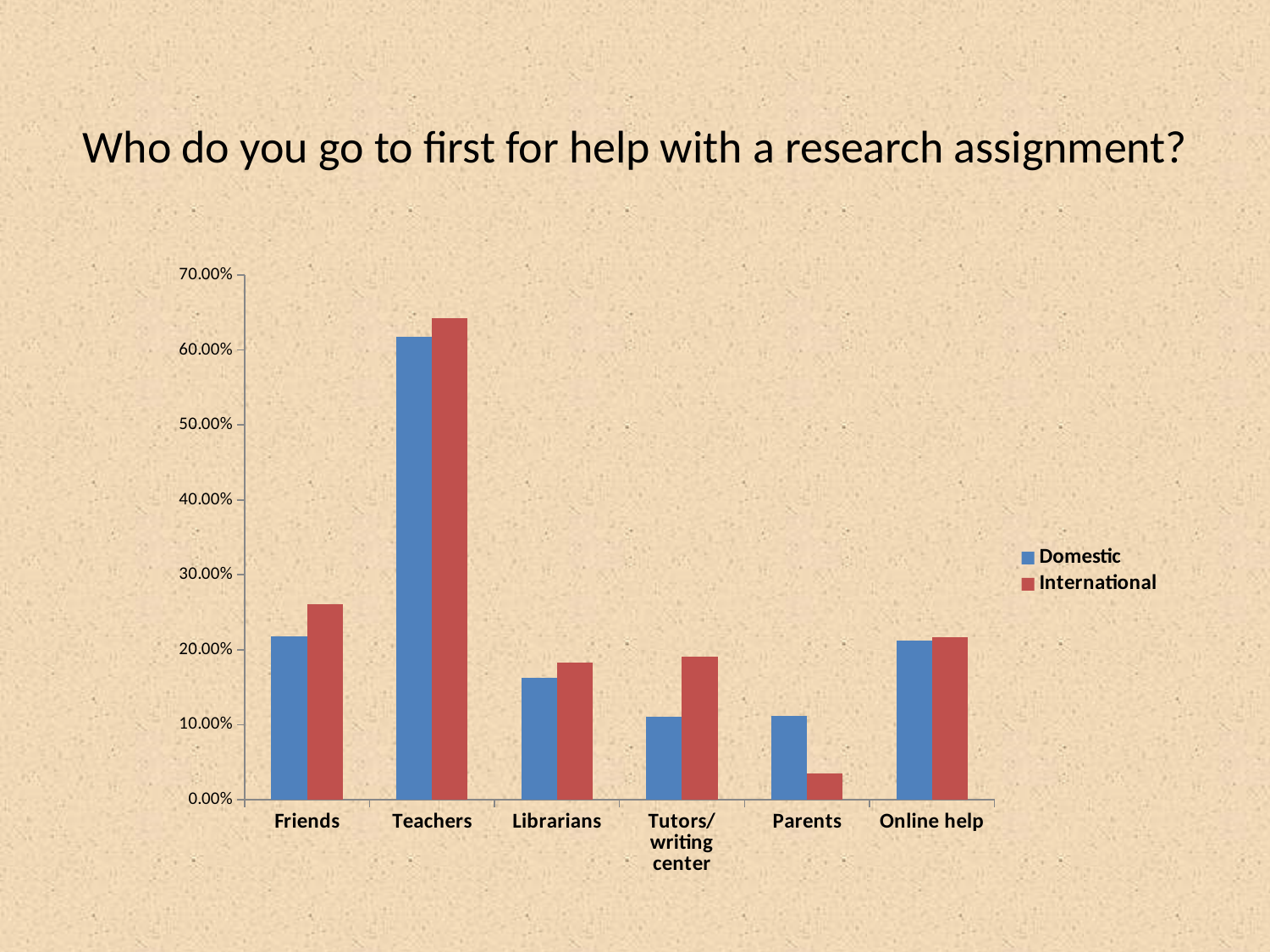
Which category has the highest Domestic value? Teachers For Friends, which series has the larger value, Domestic or International? International Which category has the highest International value? Teachers Which category has the lowest International value? Parents What kind of chart is shown on the slide? bar chart What colour represents the International series in the chart? red For Parents, which series has the larger value, Domestic or International? Domestic How many categories are shown on the x axis of the chart? 6 Is the International value for Parents greater or less than 10.00%? less Is the Domestic value for Teachers greater or less than 50.00%? greater For Tutors/writing center, which series has the larger value, Domestic or International? International How many series does the legend list? 2